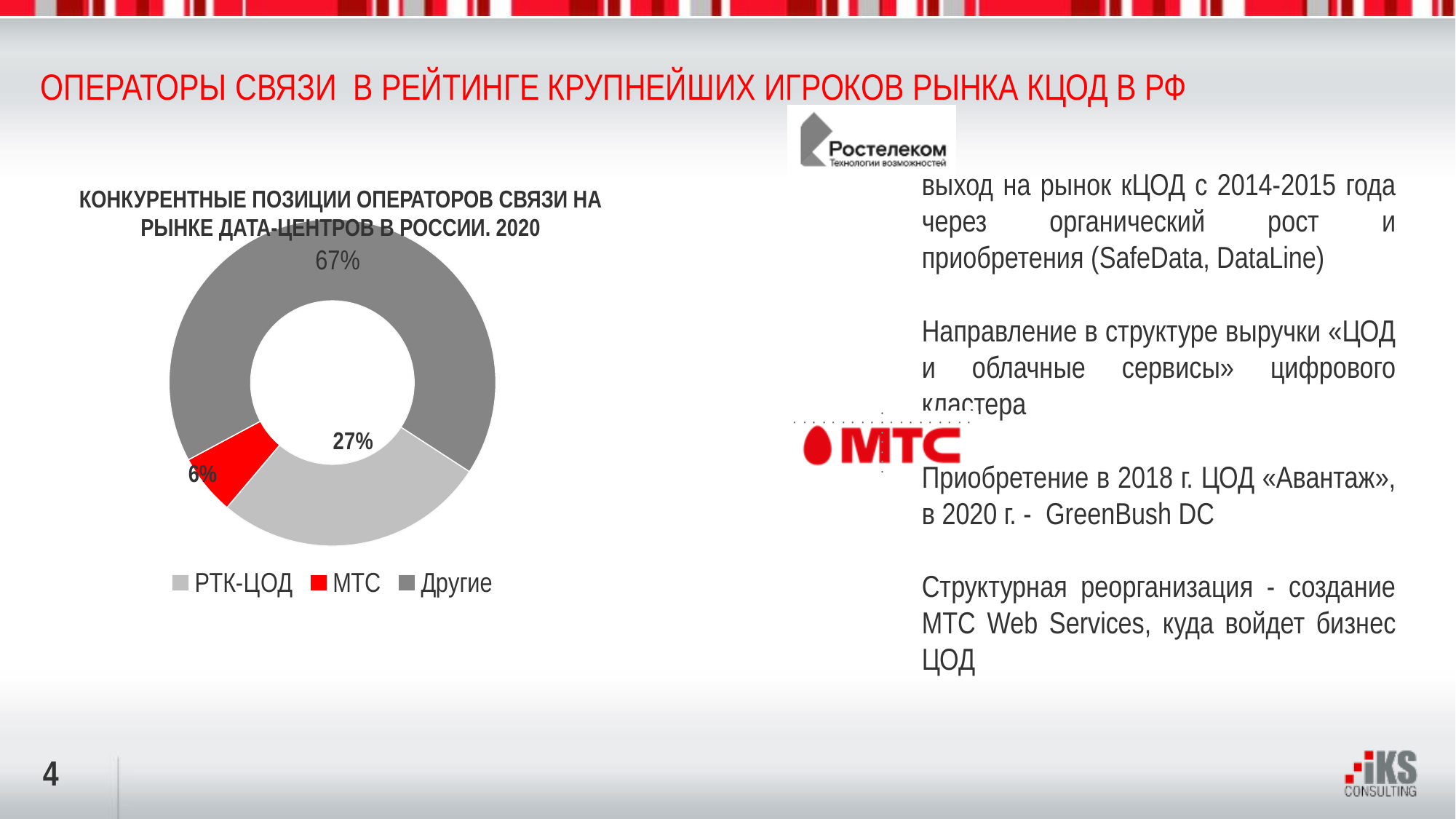
What share of the market does Другие hold in the chart? 67% What is the title of the chart? КОНКУРЕНТНЫЕ ПОЗИЦИИ ОПЕРАТОРОВ СВЯЗИ НА РЫНКЕ ДАТА-ЦЕНТРОВ В РОССИИ. 2020 What is the difference in percentage points between the shares of Другие and РТК-ЦОД? 40 Which category has the largest share in the chart? Другие What share of the market does МТС hold in the chart? 6% Which has a larger share, РТК-ЦОД or МТС? РТК-ЦОД What is the difference in percentage points between the shares of РТК-ЦОД and МТС? 21 Which category has the smallest share in the chart? МТС What type of chart is shown on the slide? Pie chart (doughnut) What share of the market does РТК-ЦОД hold in the chart? 27% How many categories are shown in the chart? 3 Which colour represents МТС in the chart? Red